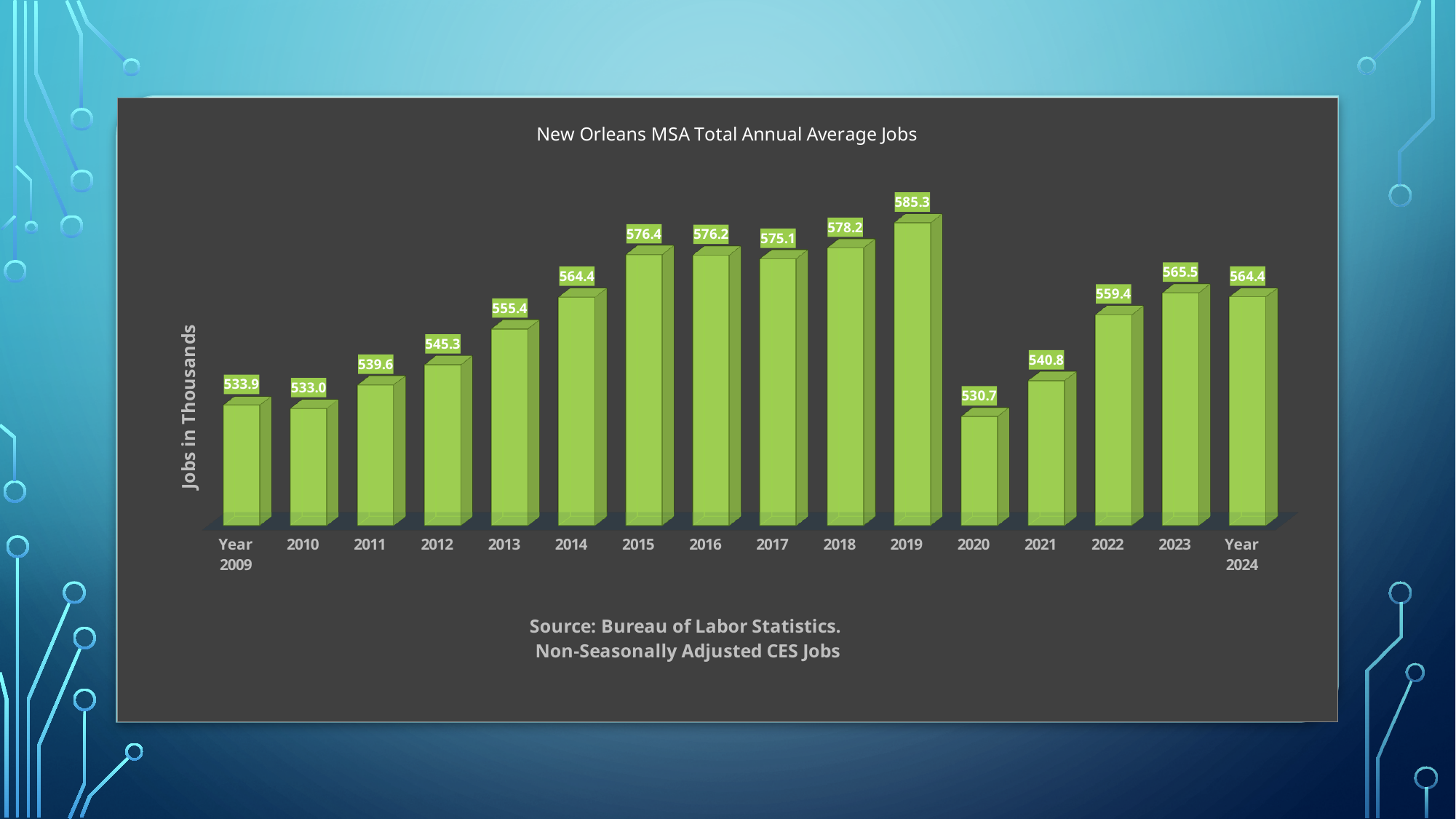
What is the difference between the values for 2019 and 2020? 54.6 What is the title of the chart? New Orleans MSA Total Annual Average Jobs Which year has the lowest value? 2020 How many years are shown on the x axis? 16 What is the value for 2020? 530.7 What is the value for Year 2024? 564.4 What kind of chart is this? Bar chart What is the difference between the values for 2023 and Year 2024? 1.1 Which is larger, the value for 2015 or the value for 2018? 2018 Which year has the highest value? 2019 Do the values rise or fall from Year 2009 to 2019? Rise What is the value for 2019? 585.3